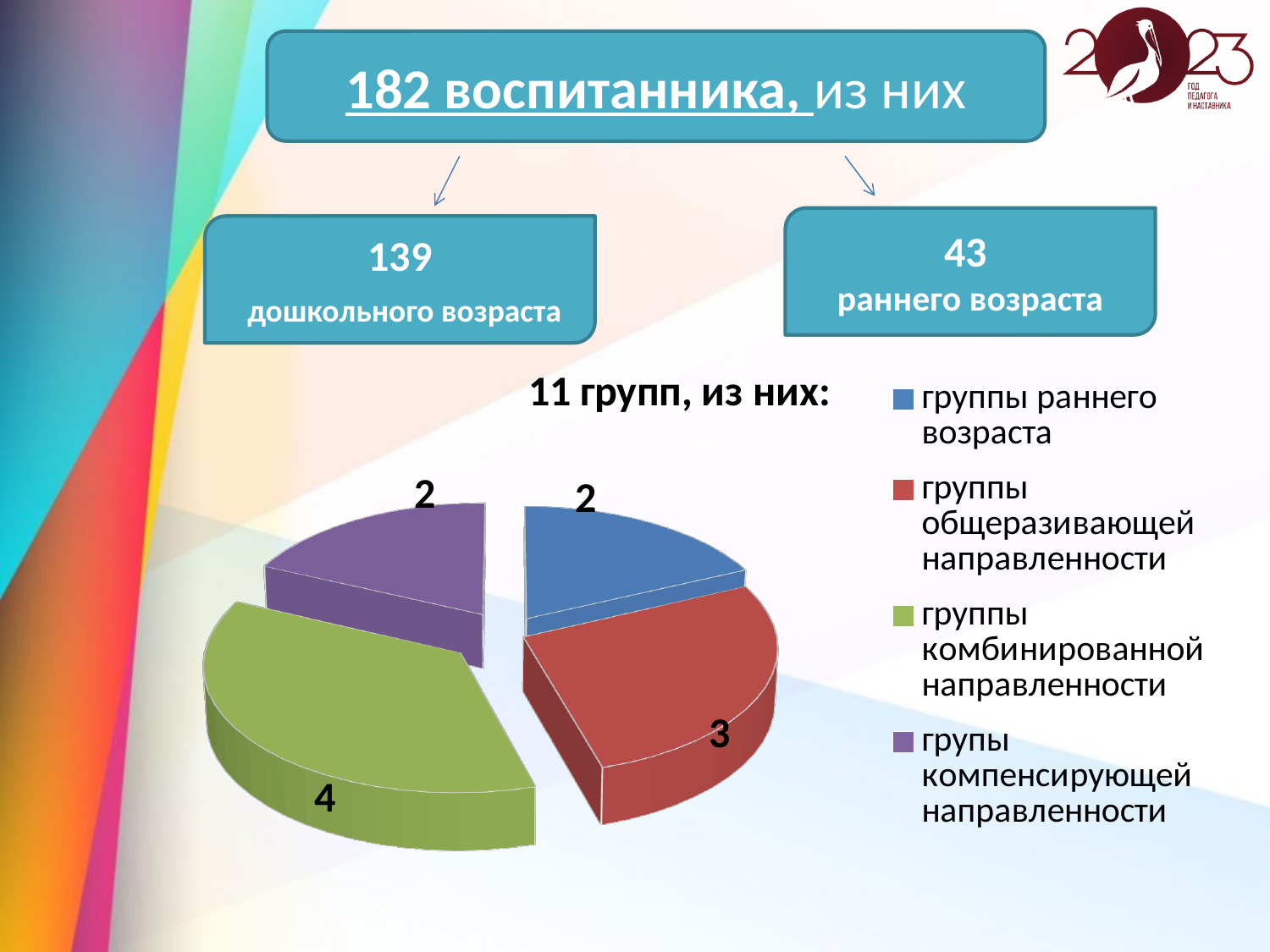
What is the title of the pie chart? 11 групп, из них: Which category has the largest slice in the pie chart? группы комбинированной направленности Which is larger in the pie chart: группы общеразивающей направленности or группы раннего возраста? группы общеразивающей направленности What is the difference between the values for группы комбинированной направленности and группы общеразивающей направленности? 1 What is the value for групы компенсирующей направленности in the pie chart? 2 How many slices does the pie chart have? 4 What colour is the slice for группы комбинированной направленности in the pie chart? green What kind of chart is shown on the slide? pie chart What is the value for группы раннего возраста in the pie chart? 2 What is the value for группы общеразивающей направленности in the pie chart? 3 How many entries does the legend of the pie chart list? 4 What is the value for группы комбинированной направленности in the pie chart? 4